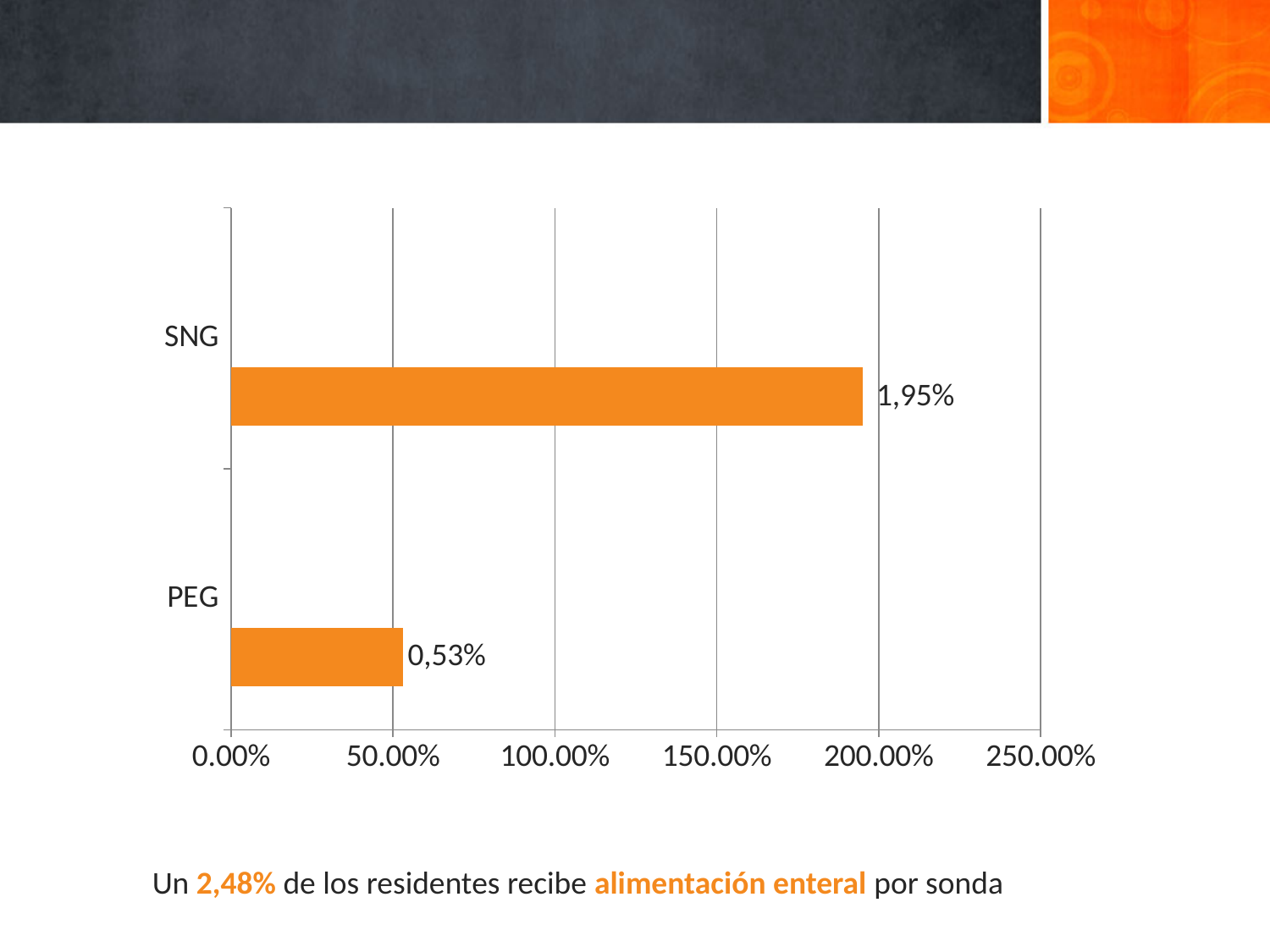
What colour are the bars in the chart? Orange Which category has the highest value? SNG What is the value shown for PEG? 0,53% What is the value shown for SNG? 1,95% What is the combined value of SNG and PEG? 2,48% Which is larger, the value for SNG or the value for PEG? SNG What is the highest value labelled on the horizontal axis? 250.00% What is the difference between the values for SNG and PEG? 1,42% Is the bar for PEG greater or less than 100.00% on the axis? less Which category has the lowest value? PEG What kind of chart is shown on the slide? Bar chart How many categories are shown in the chart? 2